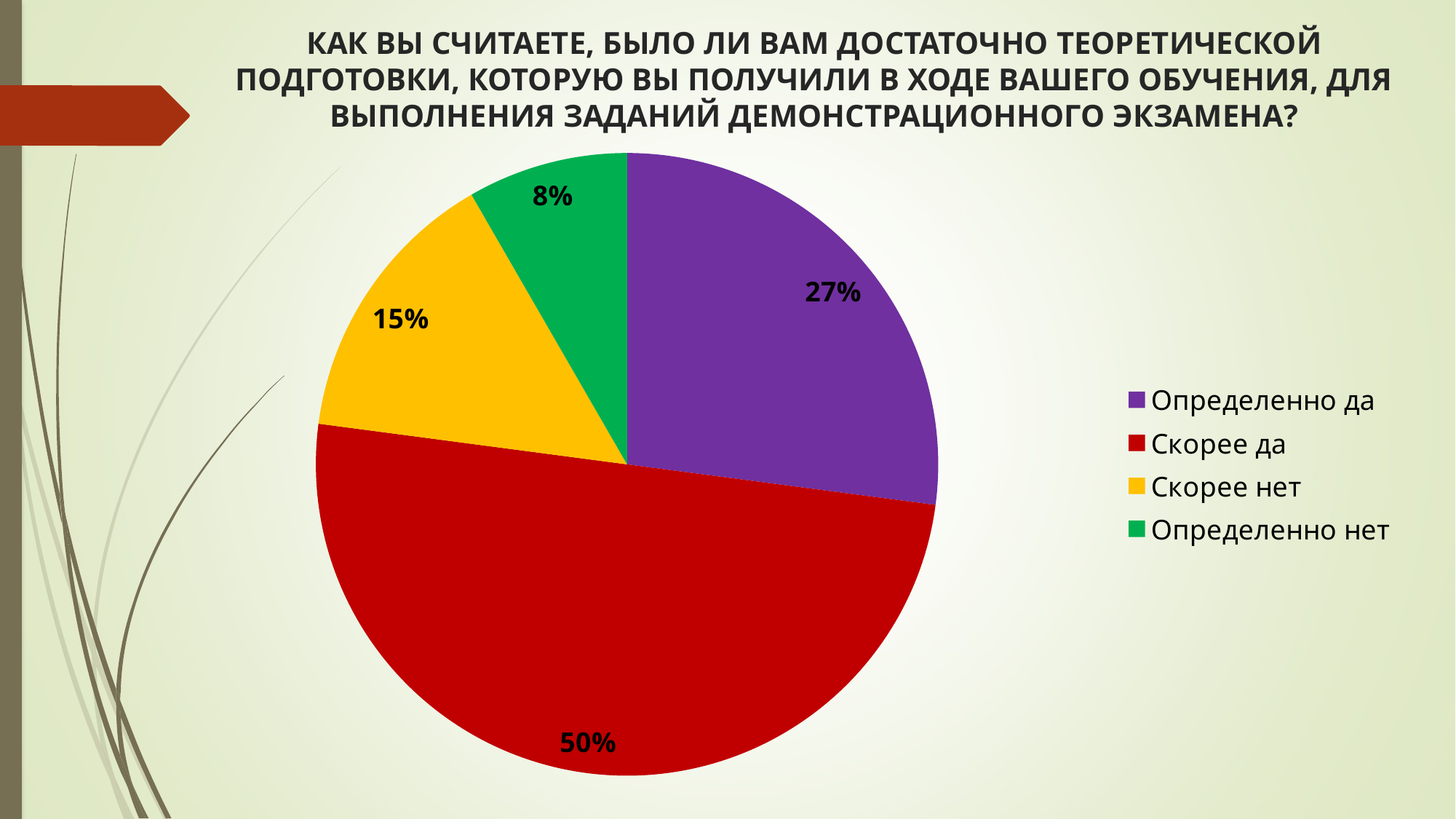
Which category has the smallest slice of the pie? Определенно нет What is the difference in percentage points between "Скорее да" and "Определенно да"? 23 What colour is the slice for "Скорее нет"? yellow Which category has the largest slice of the pie? Скорее да What share of the pie does "Скорее нет" have? 15% What share of the pie does "Определенно да" have? 27% What share of the pie does "Скорее да" have? 50% What type of chart is shown on the slide? pie chart How many categories does the pie chart have? 4 Which is larger, the slice for "Скорее нет" or the slice for "Определенно нет"? Скорее нет What is the combined share of "Определенно да" and "Скорее да"? 77%